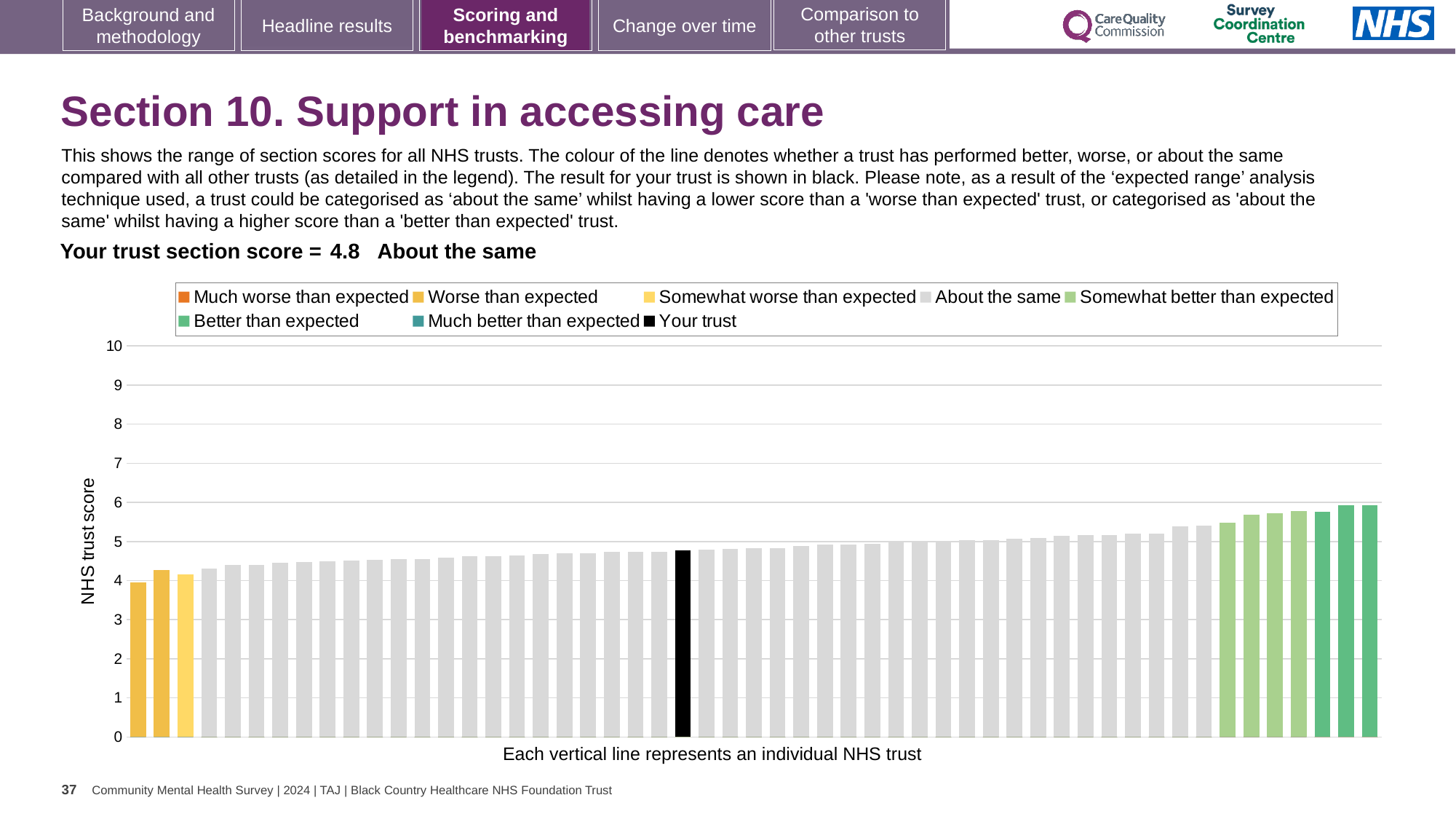
How is your trust's score categorised compared with other trusts? About the same What kind of chart is shown on the slide? bar chart What is the section score for your trust shown on the slide? 4.8 Is the value of the shortest bar greater or less than 5? less What is the title of the vertical axis? NHS trust score Is the value of the tallest bar greater or less than 7? less How many entries does the chart legend list? 8 Is the value for your trust (the black bar) greater or less than 4? greater What colour is used for the 'Your trust' bar according to the legend? black Do the bar values rise or fall from left to right along the x axis? rise